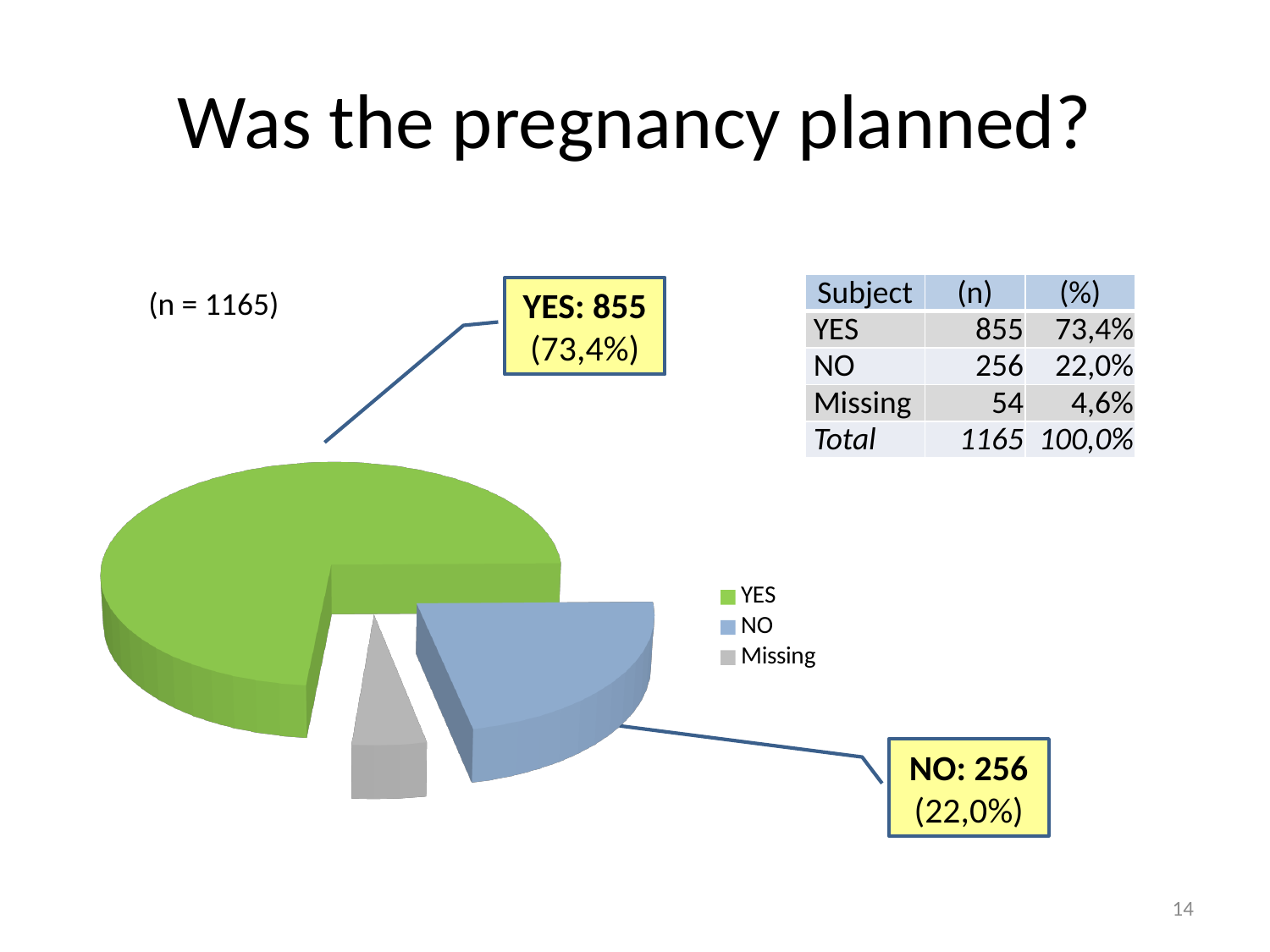
What colour is the YES slice in the pie chart? green What is the count for YES in the pie chart? 855 Which category has the largest slice of the pie? YES How many entries does the legend list? 3 How many slices does the pie chart have? 3 What percentage share does the NO slice represent? 22,0% Which category has the smallest slice of the pie? Missing What percentage share does the YES slice represent? 73,4% What kind of chart is shown on the slide? pie chart What is the difference between the YES count and the NO count? 599 What is the count for NO in the pie chart? 256 Which is larger, the NO slice or the Missing slice? NO